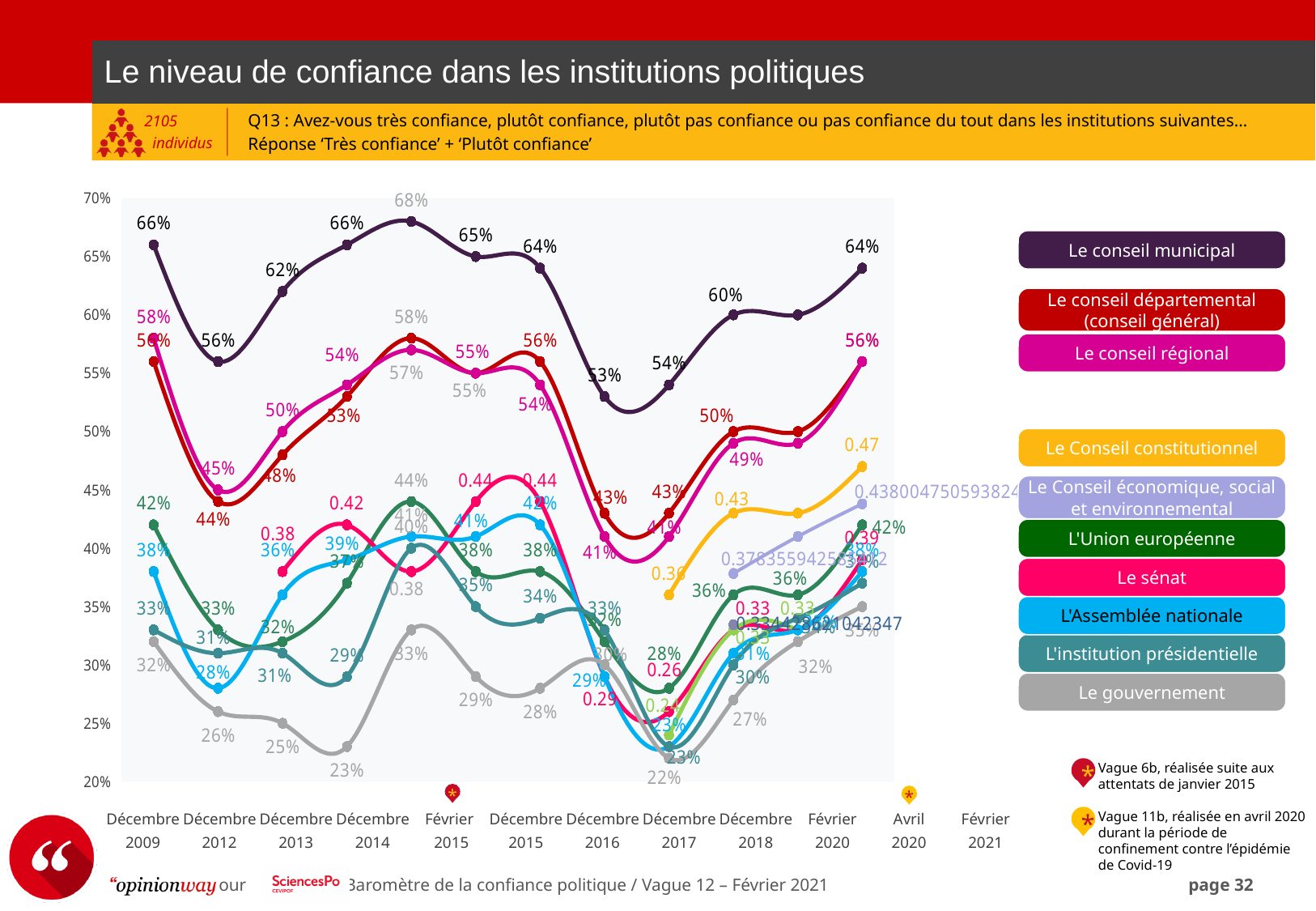
In which period does Le conseil municipal reach its lowest value? Décembre 2016 What kind of chart is shown on the slide? Line chart In which period does Le conseil municipal reach its highest value? Février 2015 What is the difference between the Le conseil municipal values in Décembre 2009 and Décembre 2012? 10 percentage points What is the value for Le Conseil constitutionnel in Février 2021? 0.47 What is the value for Le conseil municipal in Février 2015? 68% In Février 2021, which is higher: Le conseil municipal or Le conseil régional? Le conseil municipal What is the value for Le gouvernement in Décembre 2017? 22% Does the value for Le conseil municipal rise or fall between Décembre 2017 and Février 2021? Rise How many series does the legend list? 10 In which period does Le gouvernement reach its lowest value? Décembre 2017 What is the value for Le conseil départemental (conseil général) in Décembre 2012? 44%